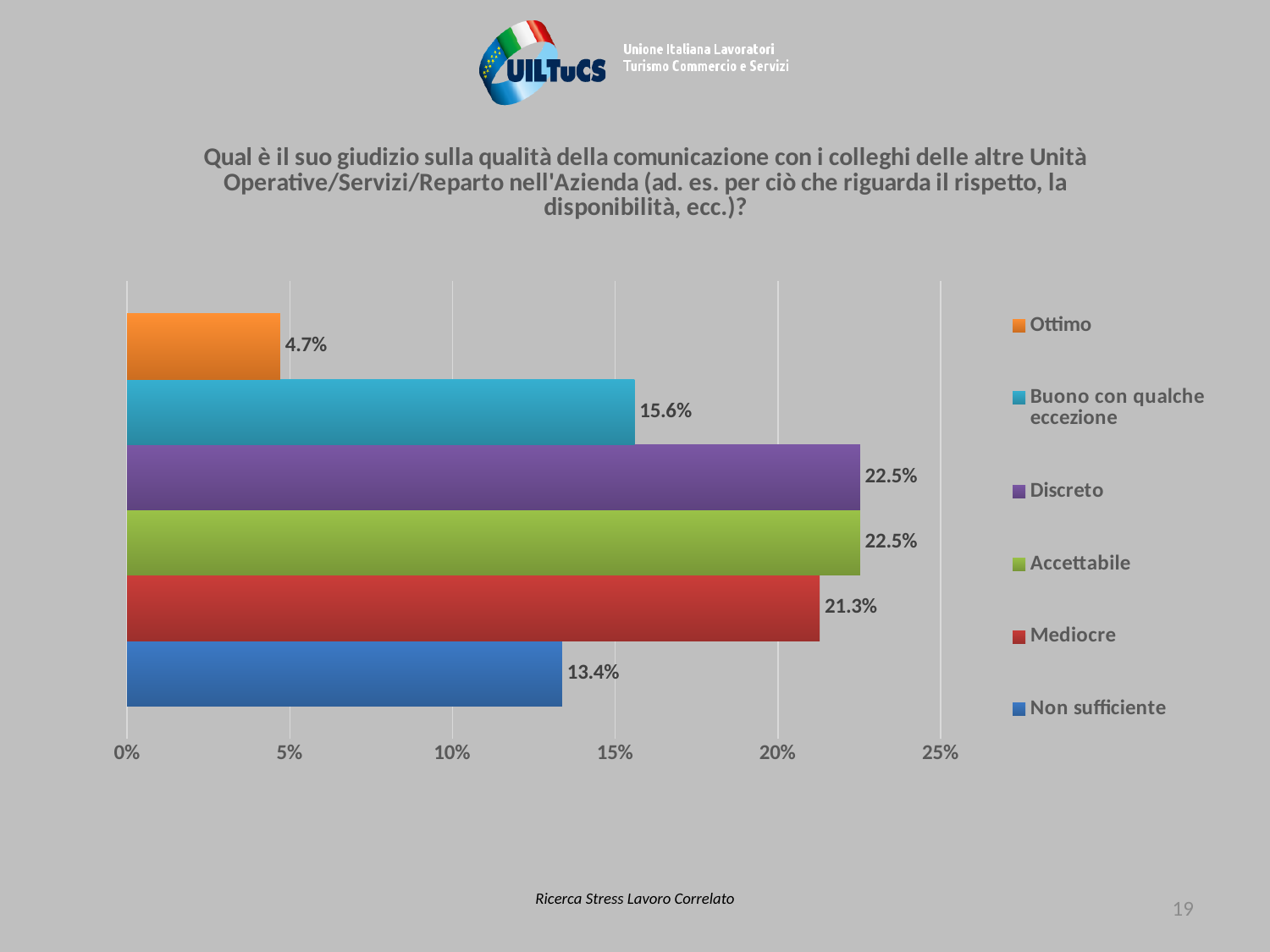
What is the value for Non sufficiente? 13.4% How many entries does the legend list? 6 Is the value for Mediocre greater or less than 20%? greater What is the value for Buono con qualche eccezione? 15.6% How many bars are plotted in the chart? 6 What is the difference between the values for Mediocre and Non sufficiente? 7.9 percentage points What is the value for Mediocre? 21.3% Which is larger, the value for Buono con qualche eccezione or the value for Non sufficiente? Buono con qualche eccezione What is the value for Ottimo? 4.7% What kind of chart is shown on the slide? Bar chart What is the value for Discreto? 22.5% Which category has the lowest value? Ottimo